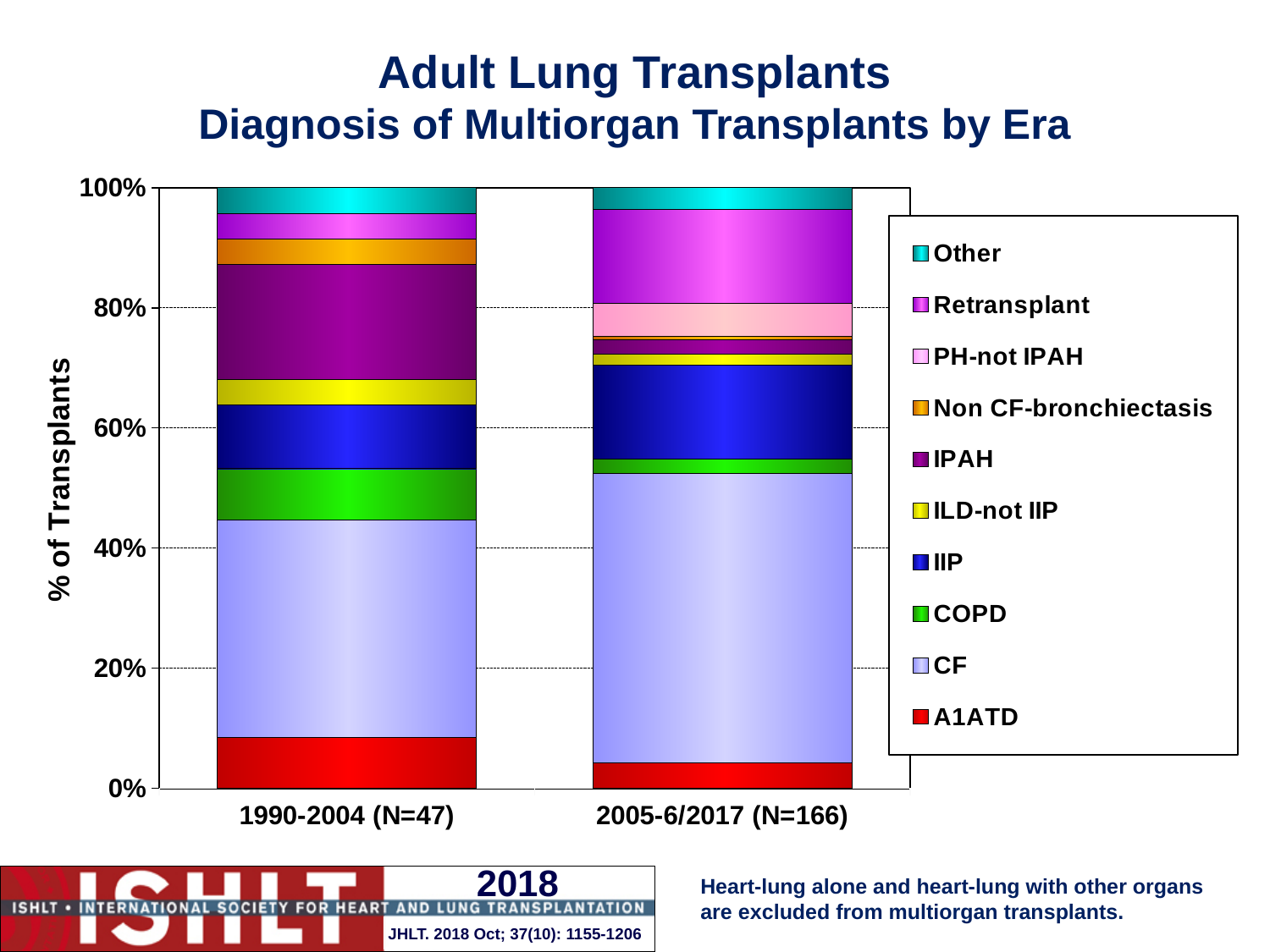
Is the CF share of transplants in the 2005-6/2017 era greater or less than 40%? greater Is the COPD share larger in the 1990-2004 era or the 2005-6/2017 era? 1990-2004 Is the A1ATD share of transplants in the 1990-2004 era greater or less than 20%? less Which diagnosis makes up the largest share of the 1990-2004 (N=47) bar? CF What kind of chart is shown on the slide? Stacked bar chart How many diagnosis series does the legend list? 10 Which diagnosis makes up the largest share of the 2005-6/2017 (N=166) bar? CF Is the CF share larger in the 1990-2004 era or the 2005-6/2017 era? 2005-6/2017 What is the number of transplants (N) for the 2005-6/2017 era shown on the x axis? N=166 Is the IPAH share larger in the 1990-2004 era or the 2005-6/2017 era? 1990-2004 How many era categories are plotted on the x axis? 2